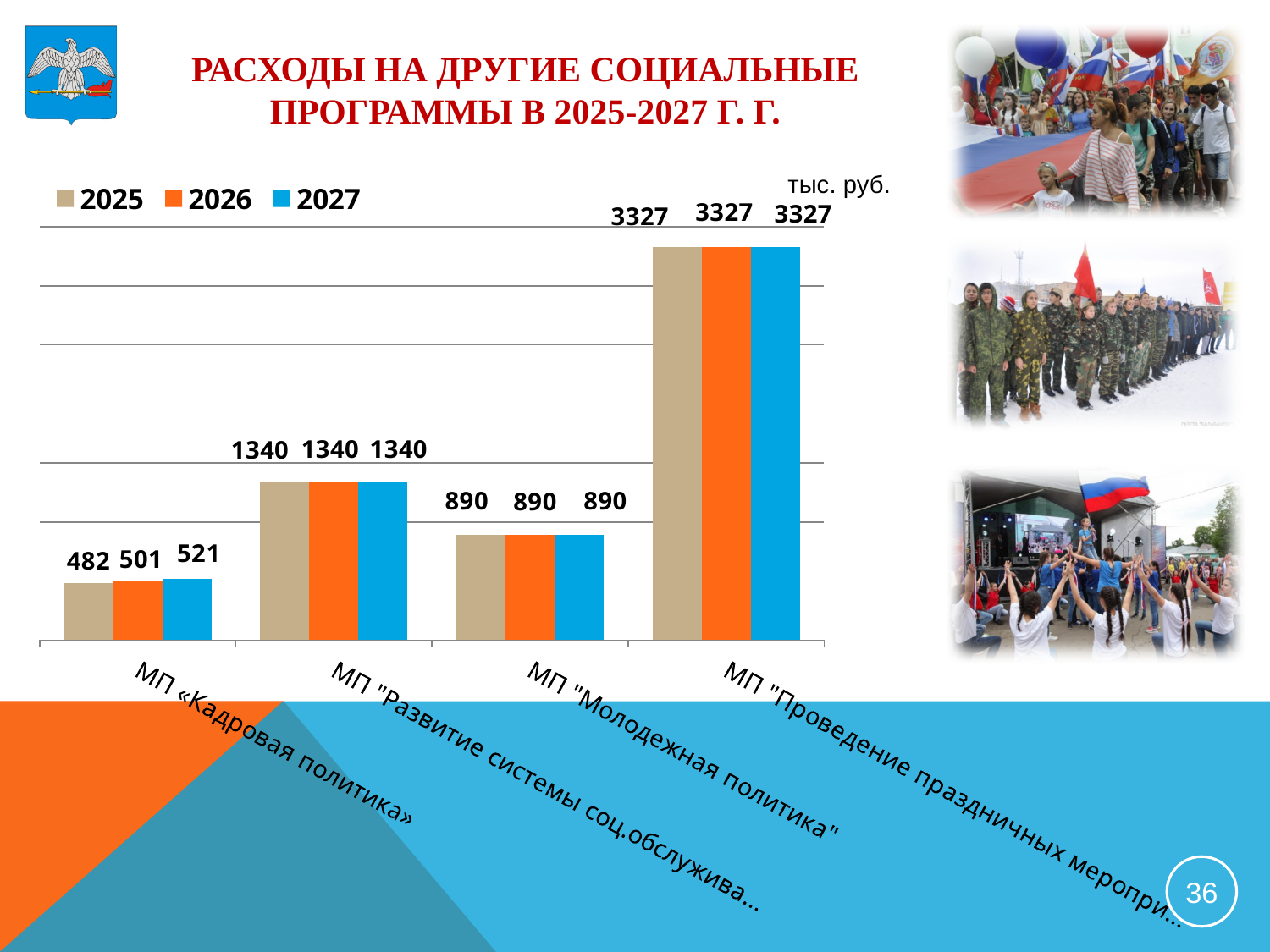
Which category has the lowest values across all three years? МП «Кадровая политика» Which is larger: the 2025 value for МП "Развитие системы соц.обслужива..." or the 2025 value for МП "Молодежная политика"? МП "Развитие системы соц.обслужива..." How many categories are shown on the x axis of the chart? 4 What is the difference between the 2027 and 2025 values for МП «Кадровая политика»? 39 Do the values for МП «Кадровая политика» rise or fall from 2025 to 2027? Rise What kind of chart is shown on the slide? Bar chart How many series does the legend list? 3 What is the value for МП "Молодежная политика" in 2026? 890 What is the value for МП «Кадровая политика» in 2027? 521 Which category has the highest values across all three years? МП "Проведение праздничных меропри..." What is the 2027 value for МП "Проведение праздничных меропри..."? 3327 What is the value for МП «Кадровая политика» in 2025? 482